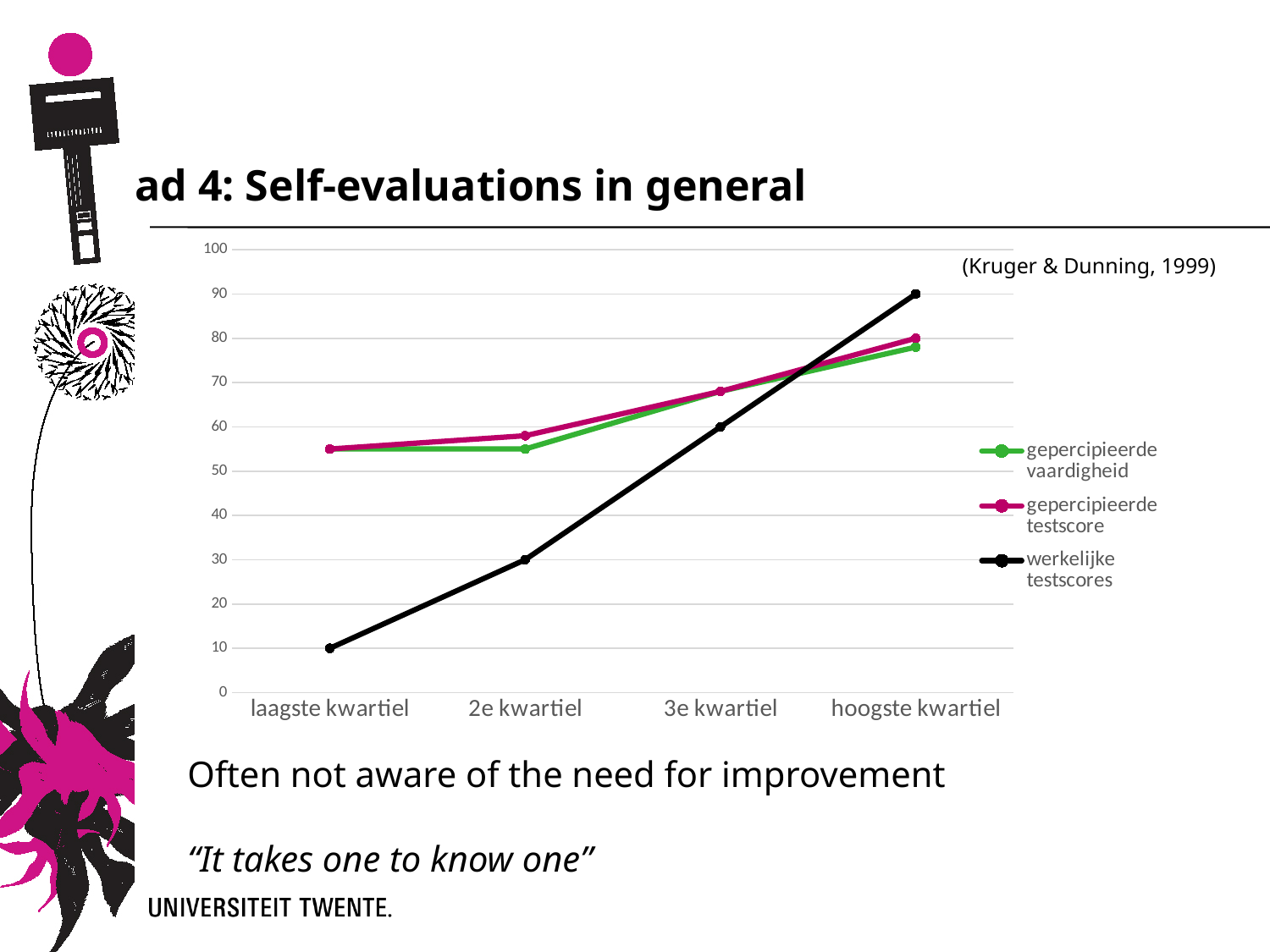
For laagste kwartiel, which is larger: gepercipieerde vaardigheid or werkelijke testscores? gepercipieerde vaardigheid Which category has the highest value for gepercipieerde testscore? hoogste kwartiel What is the value of werkelijke testscores for 2e kwartiel? 30 Which category has the lowest value for werkelijke testscores? laagste kwartiel What is the value of werkelijke testscores for hoogste kwartiel? 90 What is the value of werkelijke testscores for laagste kwartiel? 10 What kind of chart is shown on the slide? line chart How many series does the legend list? 3 Is the value of gepercipieerde testscore for 3e kwartiel greater or less than 70? less How many categories are shown on the x axis? 4 Is the value of gepercipieerde vaardigheid for laagste kwartiel greater or less than 50? greater Do the werkelijke testscores rise or fall from laagste kwartiel to hoogste kwartiel? rise